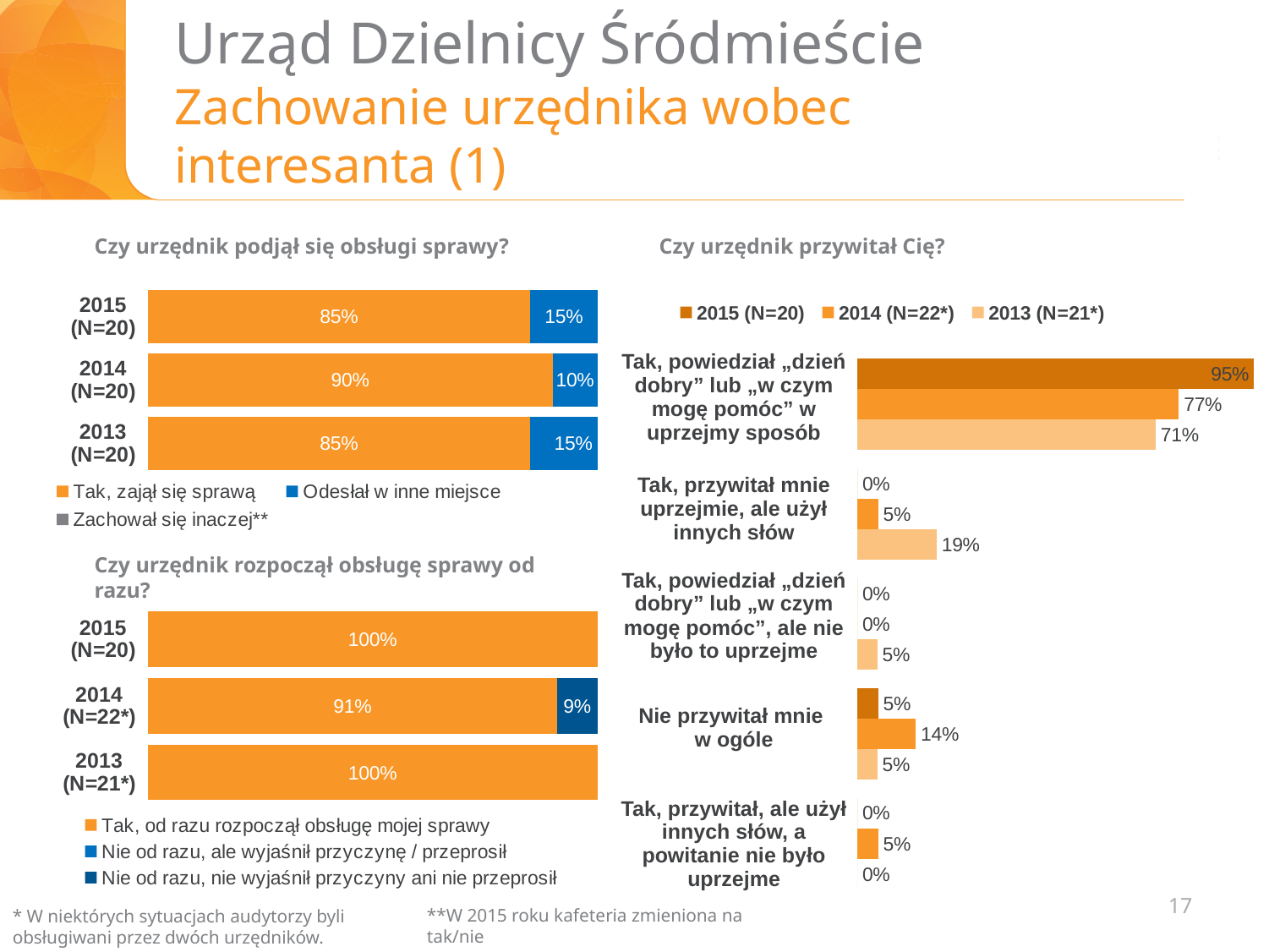
In the chart 'Czy urzędnik rozpoczął obsługę sprawy od razu?', what percentage for 2014 (N=22*) is 'Tak, od razu rozpoczął obsługę mojej sprawy'? 91% In the chart 'Czy urzędnik przywitał Cię?', what is the value for 2013 (N=21*) in the category 'Tak, przywitał mnie uprzejmie, ale użył innych słów'? 19% In the chart 'Czy urzędnik podjął się obsługi sprawy?', how many entries does the legend list? 3 In the chart 'Czy urzędnik rozpoczął obsługę sprawy od razu?', what kind of chart is shown? Stacked bar chart In the chart 'Czy urzędnik przywitał Cię?', what is the difference between the 2015 (N=20) and 2013 (N=21*) values in the category 'Tak, powiedział „dzień dobry” lub „w czym mogę pomóc” w uprzejmy sposób'? 24 percentage points In the chart 'Czy urzędnik podjął się obsługi sprawy?', what percentage for 2015 (N=20) is 'Odesłał w inne miejsce'? 15% In the chart 'Czy urzędnik przywitał Cię?', how many series does the legend list? 3 In the chart 'Czy urzędnik przywitał Cię?', which series has the highest value in the category 'Nie przywitał mnie w ogóle'? 2014 (N=22*) In the chart 'Czy urzędnik przywitał Cię?', what is the value for 2015 (N=20) in the category 'Tak, powiedział „dzień dobry” lub „w czym mogę pomóc” w uprzejmy sposób'? 95% In the chart 'Czy urzędnik przywitał Cię?', how many categories are shown? 5 In the chart 'Czy urzędnik rozpoczął obsługę sprawy od razu?', what is the total of the stacked bar for 2014 (N=22*)? 100% In the chart 'Czy urzędnik podjął się obsługi sprawy?', what percentage for 2014 (N=20) is 'Tak, zajął się sprawą'? 90%